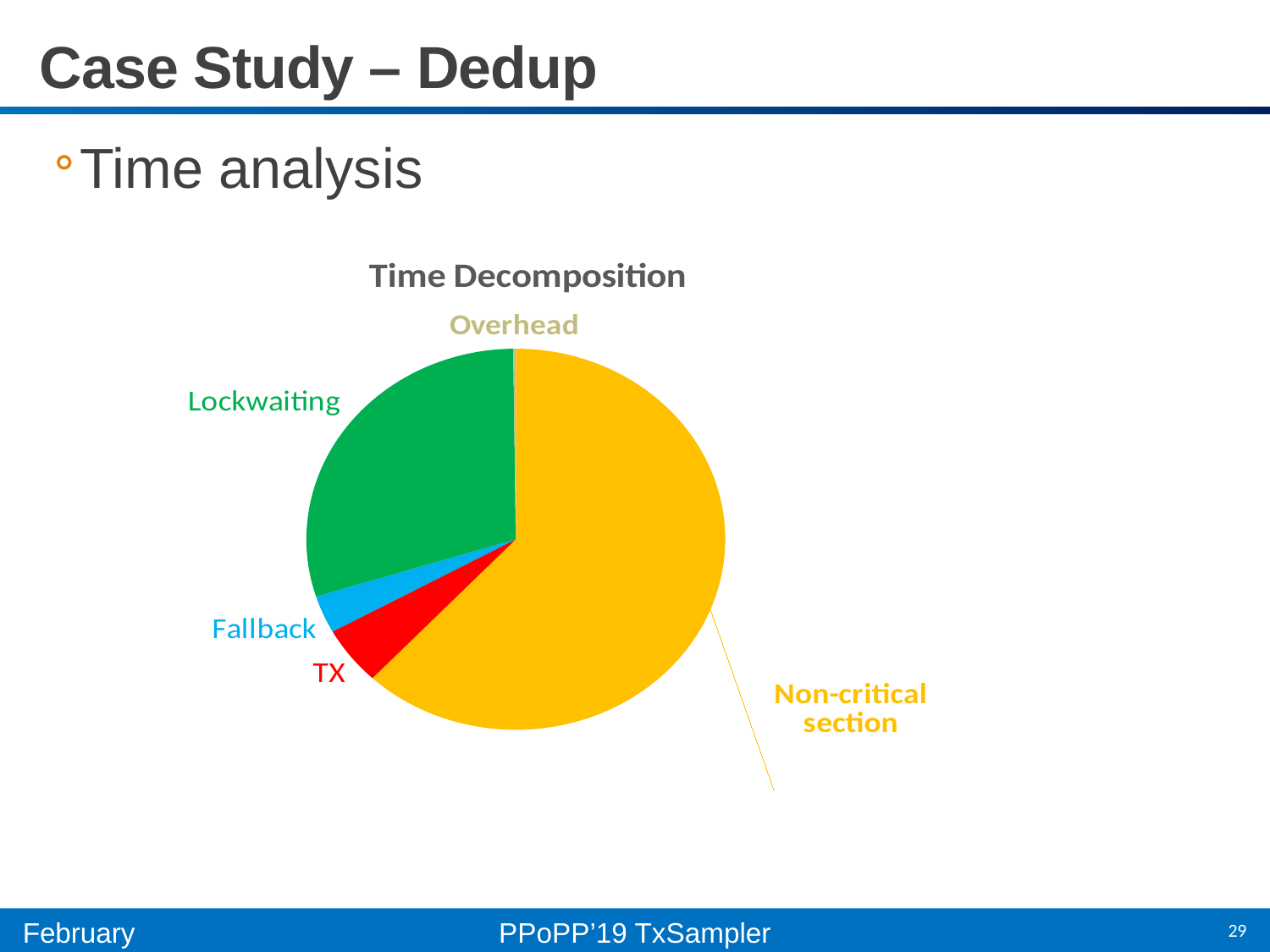
Which slice of the pie chart is the smallest? Overhead Which slice of the pie chart is the largest? Non-critical section What kind of chart is shown on the slide? pie chart Which slice is larger, Non-critical section or Lockwaiting? Non-critical section Which slice is larger, TX or Overhead? TX Which slice is the second largest in the pie chart? Lockwaiting Does the Non-critical section slice take up more or less than half of the pie? more Which slice is larger, Lockwaiting or Fallback? Lockwaiting What is the title of the chart? Time Decomposition How many slices does the pie chart have? 5 What colour is the Lockwaiting slice? green